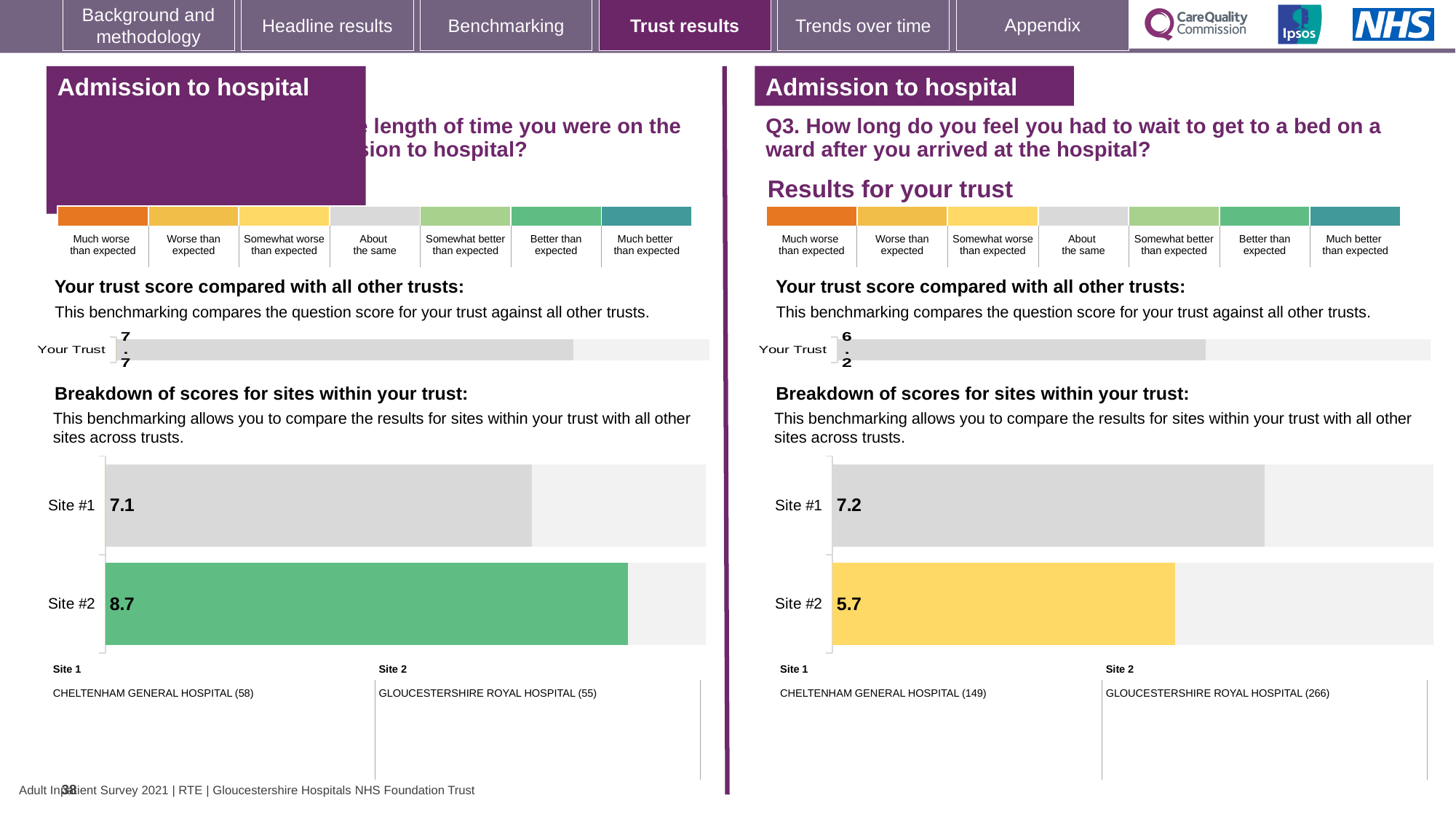
On the right-hand chart for Q3 (wait to get to a bed on a ward), what is the score for Site #2? 5.7 On the left-hand site breakdown chart, what is the score for Site #2? 8.7 On the right-hand 'Your trust score compared with all other trusts' chart for Q3, what is the score shown for Your Trust? 6.2 On the right-hand chart for Q3, which site has the higher score? Site #1 On the left-hand site breakdown chart, which site has the lower score? Site #1 What type of chart is used for the site breakdown on the right-hand side of the slide? Bar chart On the left-hand site breakdown chart, what is the score for Site #1? 7.1 How many sites are shown in the right-hand site breakdown chart for Q3? 2 On the left-hand 'Your trust score compared with all other trusts' chart, what is the score shown for Your Trust? 7.7 On the left-hand site breakdown chart, what is the difference between the Site #2 and Site #1 scores? 1.6 On the right-hand chart for Q3, what is the difference between the Site #1 and Site #2 scores? 1.5 On the right-hand chart for Q3 (wait to get to a bed on a ward), what is the score for Site #1? 7.2